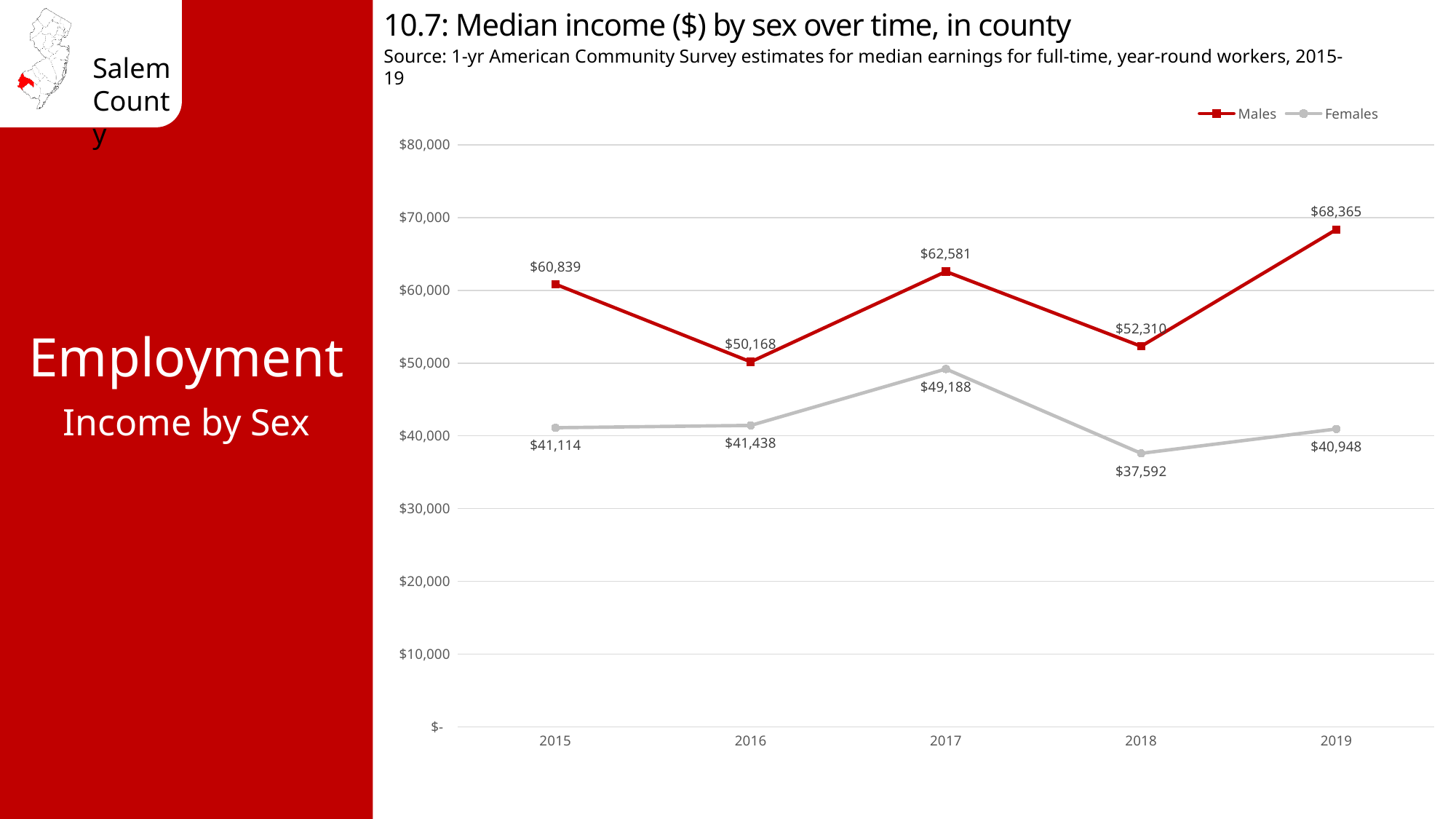
How many series does the legend list? 2 What kind of chart is shown on the slide? line chart Is the median income for Females in 2015 greater or less than $50,000? less Did the median income for Males rise or fall from 2018 to 2019? rise What was the median income for Females in 2018? $37,592 In which year was the median income for Females highest? 2017 How many years are shown on the x axis? 5 Which was larger in 2017, the median income for Males or for Females? Males In which year was the median income for Males lowest? 2016 What is the difference between the Males and Females median income in 2019? $27,417 What was the median income for Males in 2019? $68,365 What was the median income for Males in 2016? $50,168